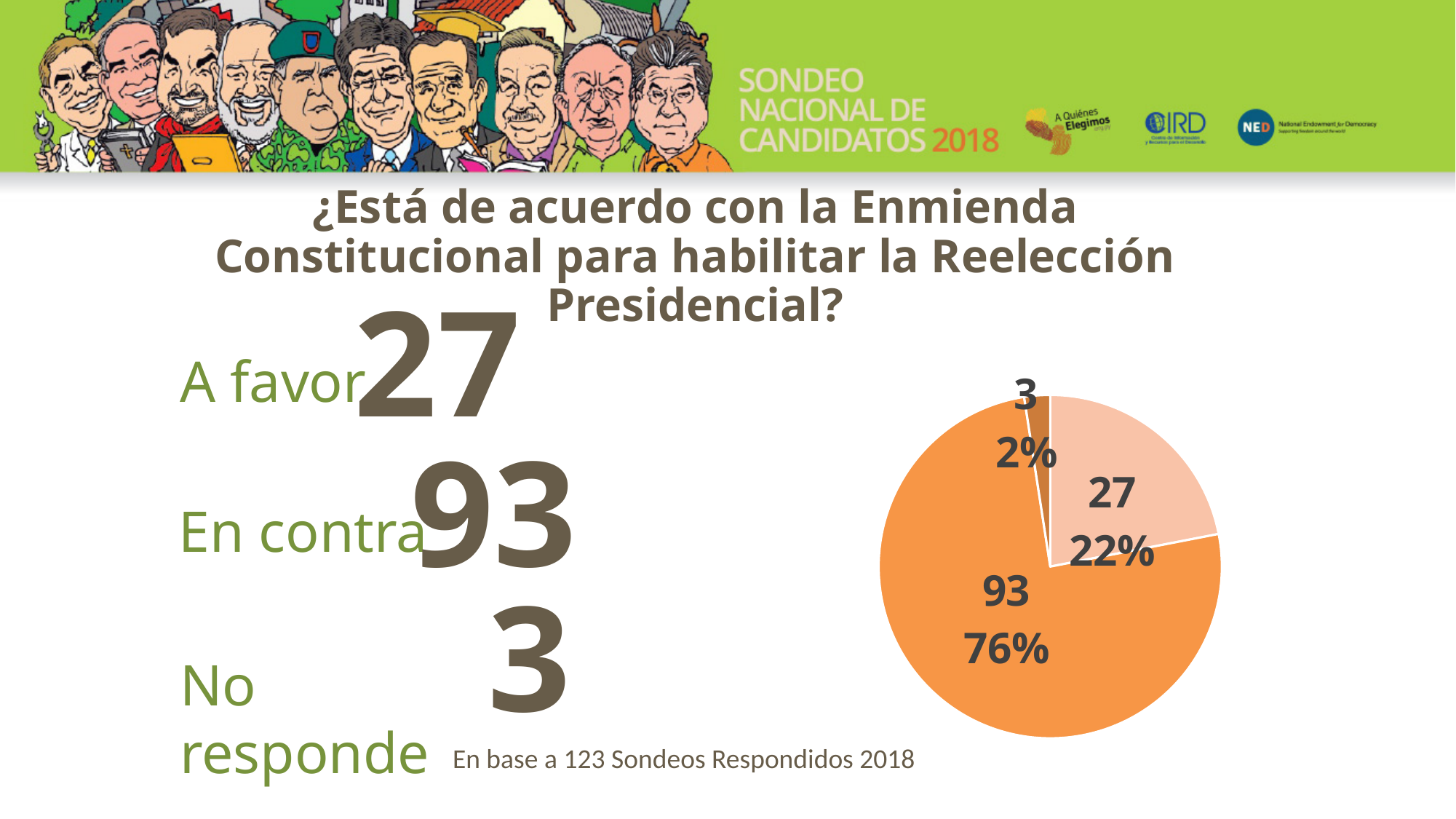
Which response category has the largest slice in the pie chart? En contra Which is larger, the value for 'A favor' or the value for 'No responde'? A favor How many slices does the pie chart have? 3 What percentage share of the pie does the slice with value 3 represent? 2% What percentage share of the pie does the slice with value 93 represent? 76% What is the value shown for 'No responde'? 3 What is the value shown for 'En contra'? 93 What is the difference between the 'En contra' value and the 'A favor' value? 66 What is the value shown for 'A favor'? 27 What kind of chart is shown on the slide? pie chart What percentage share of the pie does the slice with value 27 represent? 22% Which response category has the smallest slice in the pie chart? No responde